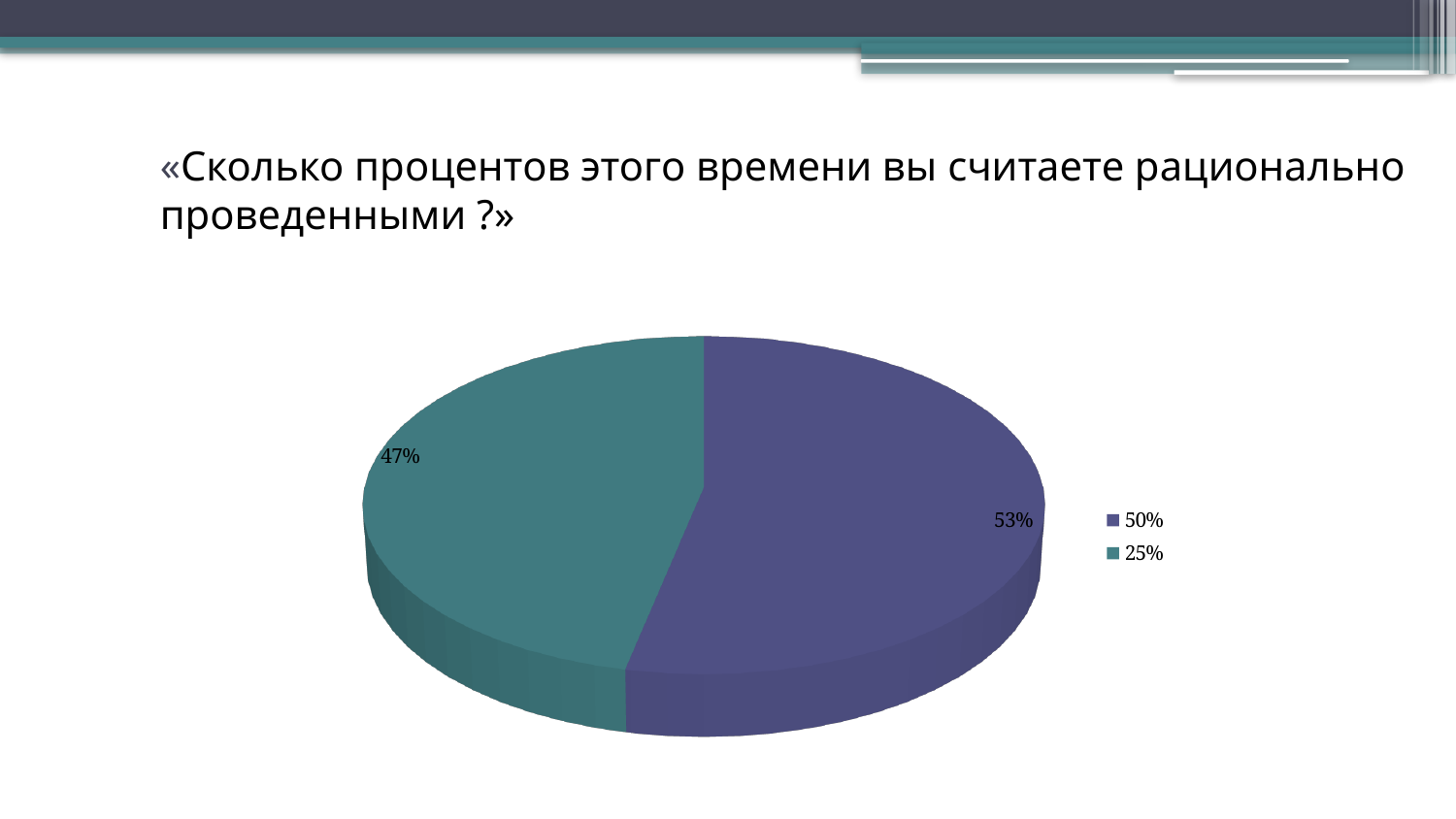
What is the total of the two slice percentages shown on the pie? 100% Which slice is larger, the one for "50%" or the one for "25%"? 50% Which category has the smallest slice of the pie? 25% What is the difference between the shares of the "50%" and "25%" categories? 6% Is the share for the "25%" category greater or less than 50%? less What kind of chart is shown on the slide? Pie chart Which category has the largest slice of the pie? 50% How many entries does the legend list? 2 What share of the pie does the "25%" category take? 47% How many slices does the pie chart have? 2 What colour is the slice for the "25%" category? Teal (green) What share of the pie does the "50%" category take? 53%